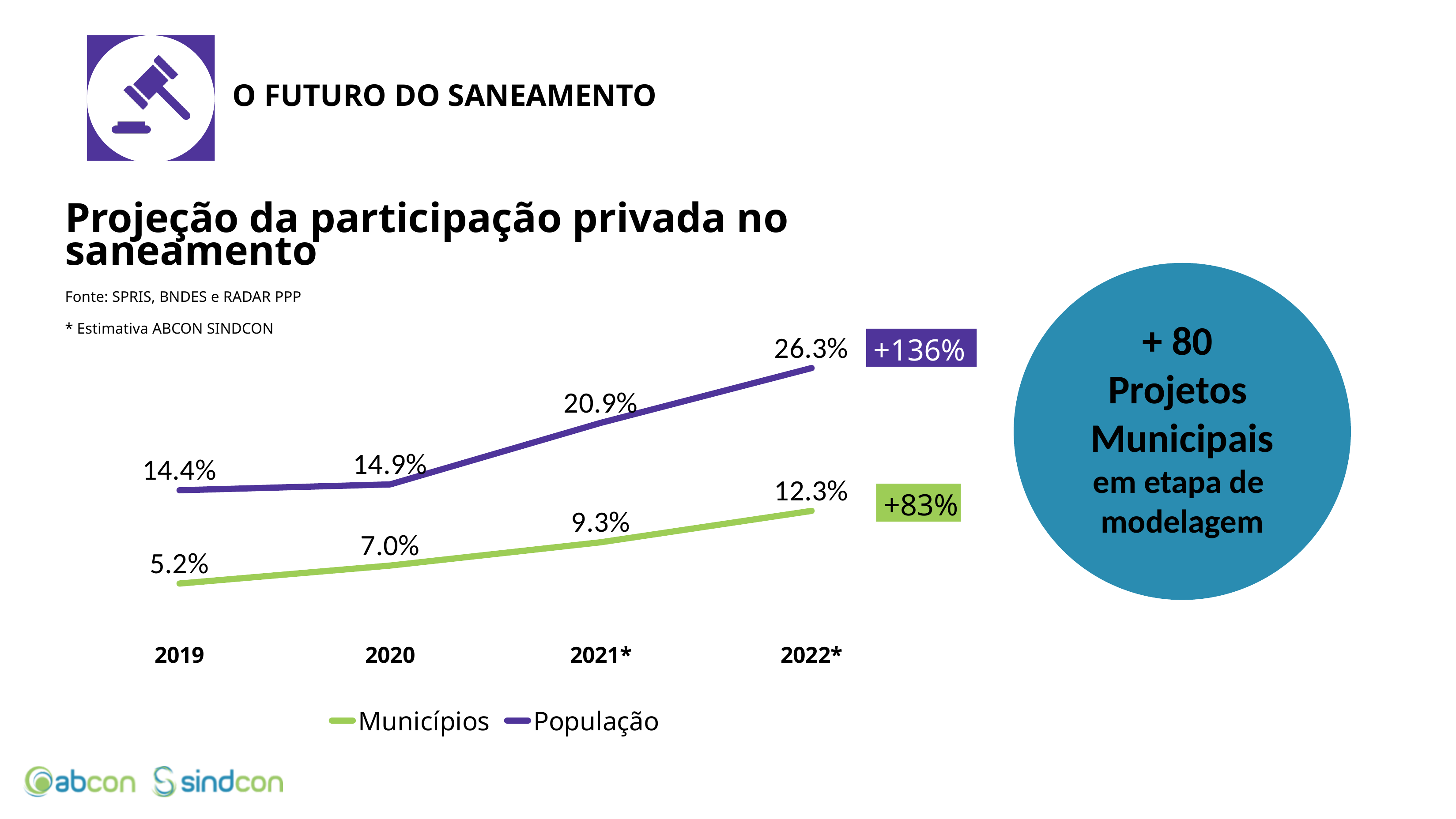
What is the value for População in 2022*? 26.3% Which is larger in 2021*, Municípios or População? População What is the value for Municípios in 2019? 5.2% How many series does the legend list? 2 What is the value for Municípios in 2020? 7.0% How many years are shown on the x axis? 4 What kind of chart is shown? Line chart What is the value for População in 2021*? 20.9% What is the difference between the População values in 2021* and 2020? 6.0% In which year is the População series lowest? 2019 What is the difference between População and Municípios in 2022*? 14.0% In which year is the Municípios series highest? 2022*